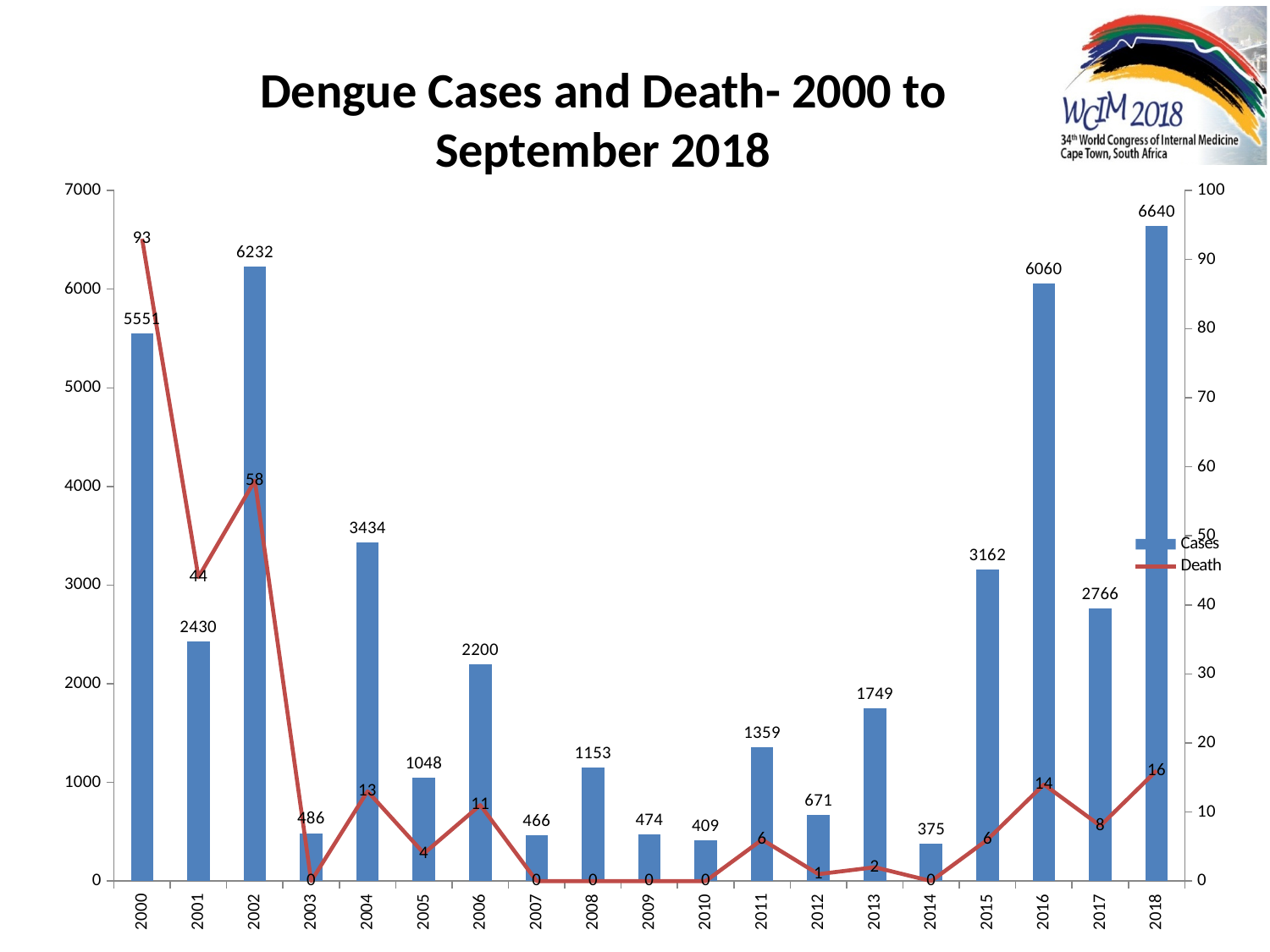
What is the difference in cases between 2018 and 2016? 580 What is the difference in deaths between 2000 and 2001? 49 Which year has the highest number of cases? 2018 How many dengue cases were reported in 2004? 3434 Which year has the lowest number of cases? 2014 How many series does the legend list? 2 What is the title of the chart? Dengue Cases and Death- 2000 to September 2018 Which year has the highest number of deaths? 2000 Which year had more cases, 2002 or 2016? 2002 How many years are shown on the x axis? 19 How many deaths were recorded in 2002? 58 What kind of chart is used to show the Cases series? bar chart